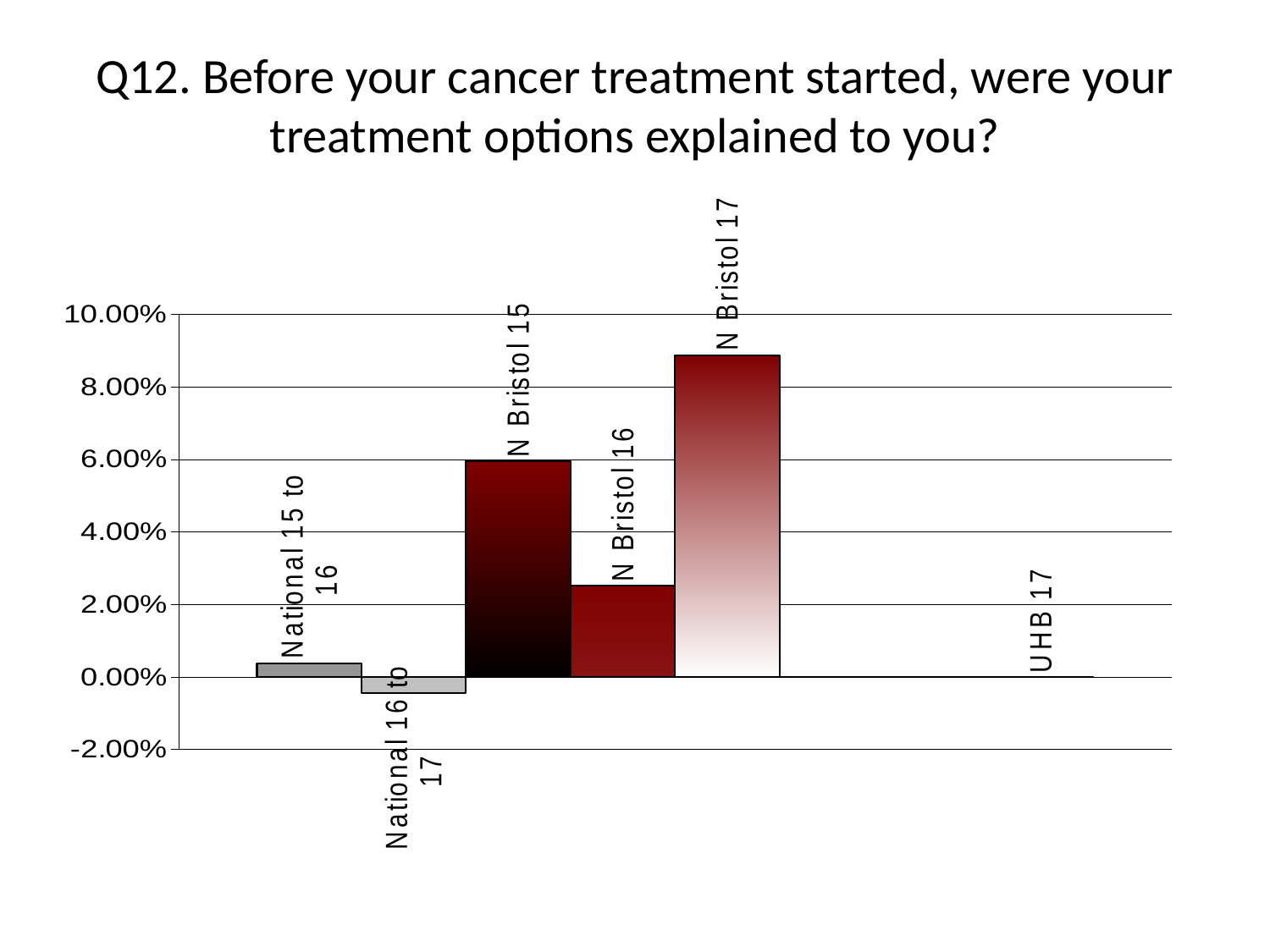
How many categories are labelled on the x axis of the chart? 6 Is the value for N Bristol 16 greater or less than 2.00%? greater Which is larger, the value for N Bristol 17 or N Bristol 15? N Bristol 17 Which category has the highest value? N Bristol 17 Is the value for N Bristol 15 greater or less than 4.00%? greater Which is larger, the value for N Bristol 15 or N Bristol 16? N Bristol 15 What kind of chart is shown on the slide? bar chart Which category has the lowest value? National 16 to 17 Is the value for N Bristol 17 greater or less than 8.00%? greater What is the title of the slide? Q12. Before your cancer treatment started, were your treatment options explained to you?